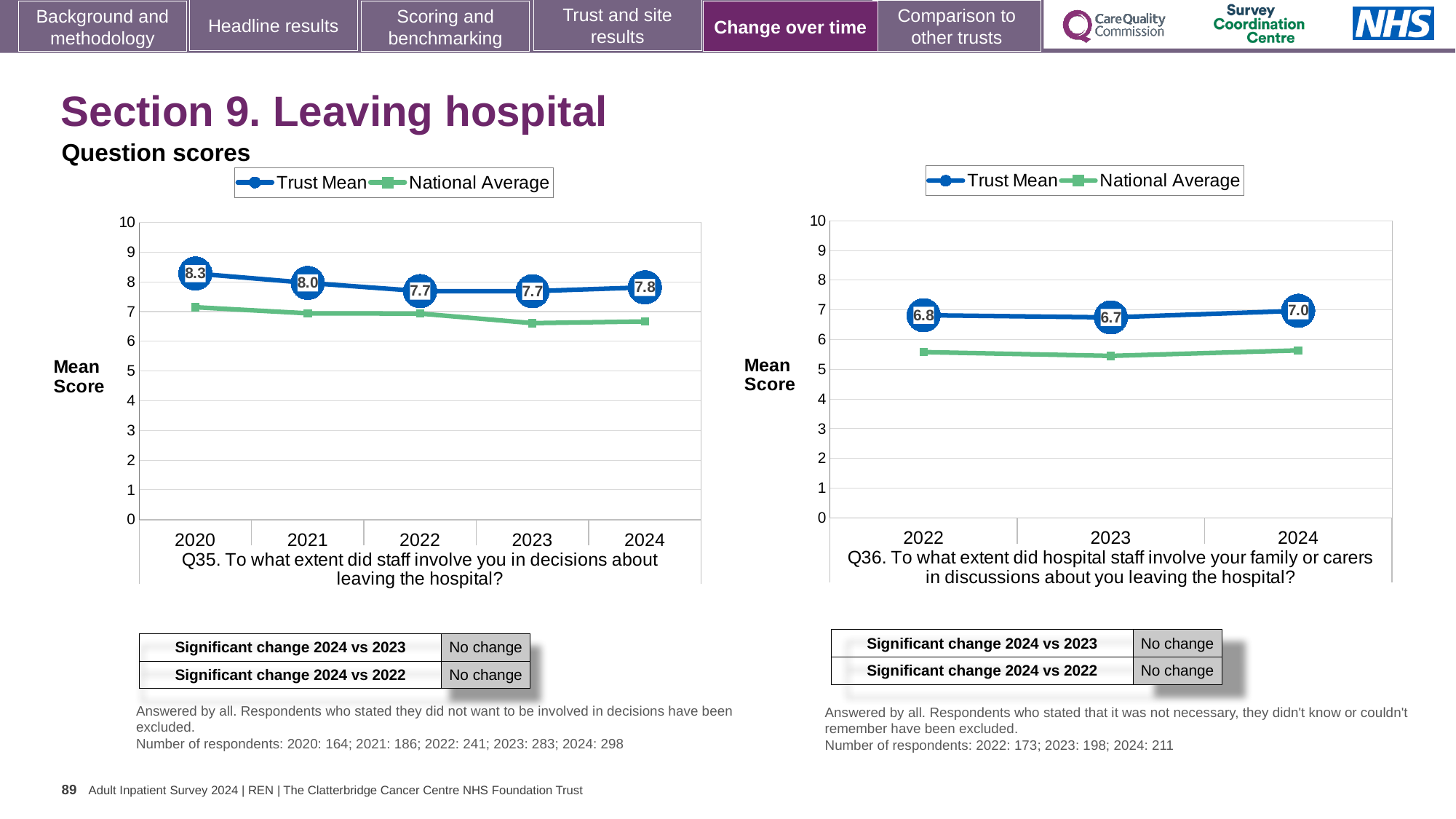
How many series does the legend of the Q35 chart (left) list? 2 What type of chart is the Q35 chart (left)? Line chart In the Q35 chart (left), what is the difference between the Trust Mean in 2020 and in 2024? 0.5 In the Q35 chart (left), what is the Trust Mean for 2020? 8.3 In the Q36 chart (right), is the National Average for 2023 greater or less than 6? less In the Q35 chart (left), does the Trust Mean rise or fall from 2020 to 2022? Fall In the Q36 chart (right), what is the Trust Mean for 2023? 6.7 In the Q35 chart (left), which year has the highest Trust Mean? 2020 How many years are plotted on the x axis of the Q36 chart (right)? 3 In the Q36 chart (right), which is larger, the Trust Mean for 2022 or for 2024? 2024 In the Q35 chart (left), what is the Trust Mean for 2024? 7.8 In the Q36 chart (right), which year has the lowest Trust Mean? 2023